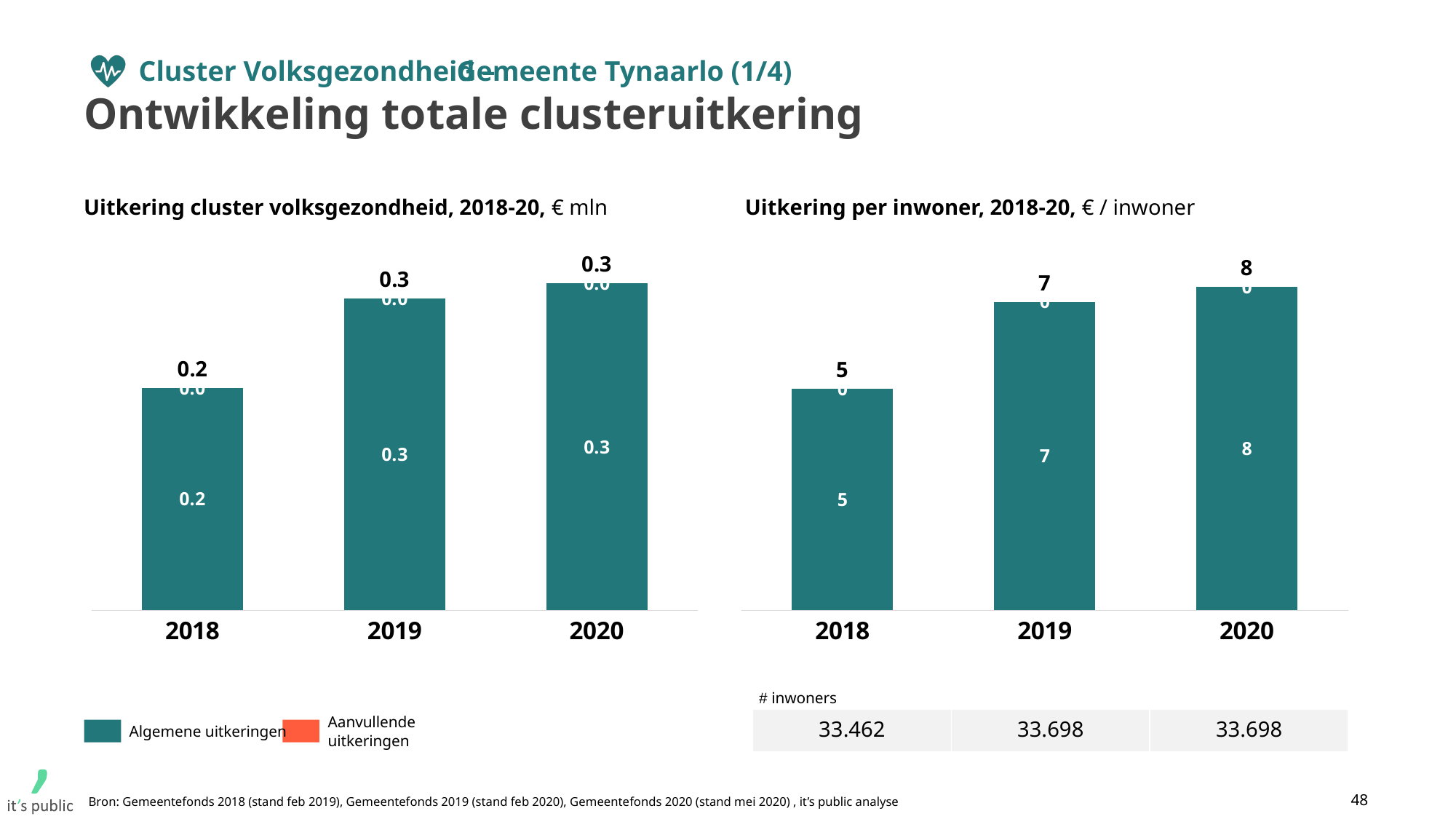
In the chart 'Uitkering cluster volksgezondheid, 2018-20', what is the total value for 2020? 0.3 In the chart 'Uitkering per inwoner, 2018-20', what is the difference between the values for 2020 and 2018? 3 In the chart 'Uitkering cluster volksgezondheid, 2018-20', what is the difference between the values for 2019 and 2018? 0.1 In the chart 'Uitkering cluster volksgezondheid, 2018-20', what is the total value for 2018? 0.2 In the chart 'Uitkering per inwoner, 2018-20', what is the value for 2019? 7 In the chart 'Uitkering per inwoner, 2018-20', is the value for 2019 larger or smaller than the value for 2018? larger How many series does the legend on the slide list? 2 In the chart 'Uitkering per inwoner, 2018-20', which year has the highest value? 2020 How many years are shown on the x axis of the chart 'Uitkering cluster volksgezondheid, 2018-20'? 3 In the chart 'Uitkering per inwoner, 2018-20', which year has the lowest value? 2018 What kind of chart is 'Uitkering per inwoner, 2018-20'? Bar chart In the chart 'Uitkering per inwoner, 2018-20', do the values rise or fall from 2018 to 2020? Rise